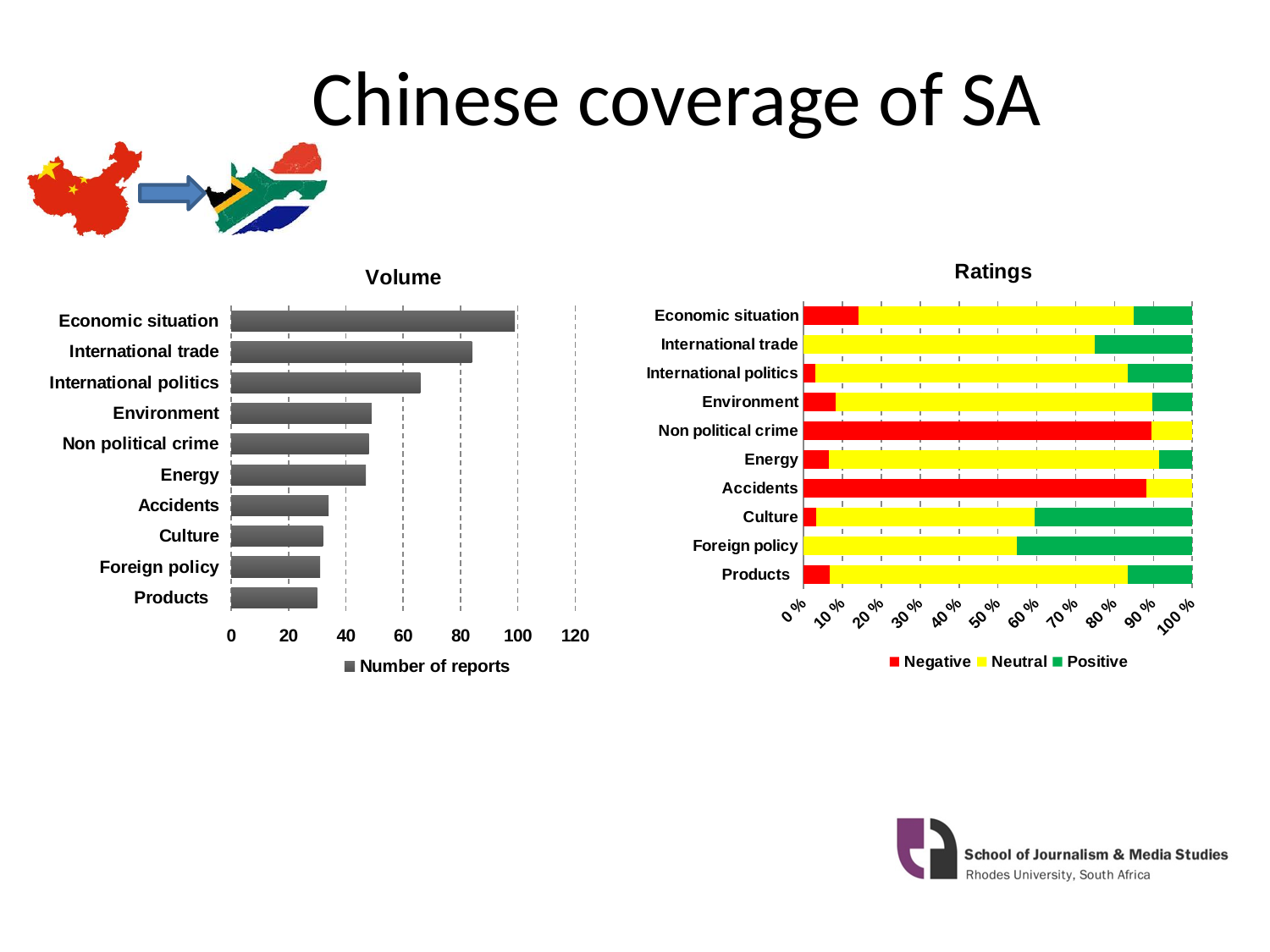
What is the name of the series in the Volume chart's legend? Number of reports In the Volume chart, which has more reports, International trade or Environment? International trade In the Ratings chart, is the Negative share for Accidents greater or less than 80 %? greater In the Volume chart, which category has the highest number of reports? Economic situation In the Volume chart, is the value for Economic situation greater or less than 80? greater In the Volume chart, is the value for International politics greater or less than 60? greater In the Ratings chart, which category has the largest Negative share? Non political crime What kind of chart is the Volume chart? bar chart In the Ratings chart, which colour represents the Neutral series? yellow How many categories are shown in the Volume chart? 10 How many series does the legend of the Ratings chart list? 3